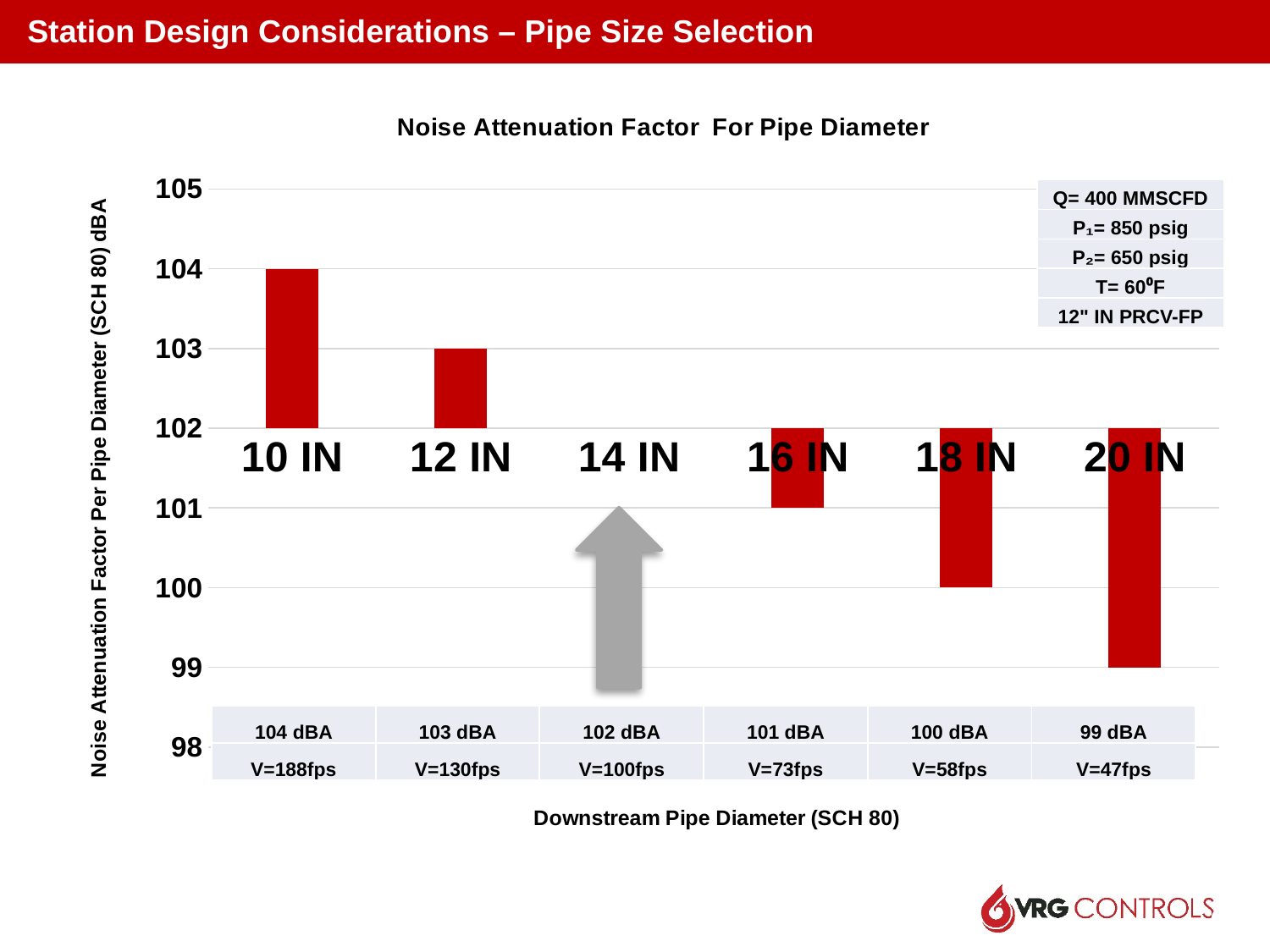
What velocity is listed for the 16 IN pipe diameter? V=73fps Which pipe diameter has the highest noise attenuation factor? 10 IN What is the difference in dBA between the 10 IN and 18 IN pipe diameters? 4 dBA Which pipe diameter has the lowest noise attenuation factor? 20 IN What is the noise attenuation factor for the 20 IN pipe diameter? 99 dBA What is the x-axis label of the chart? Downstream Pipe Diameter (SCH 80) What is the noise attenuation factor for the 10 IN pipe diameter? 104 dBA What kind of chart is shown on the slide? Bar chart Do the noise attenuation values rise or fall as the pipe diameter increases along the x axis? Fall How many pipe diameter categories are shown on the chart? 6 Which has a higher noise attenuation factor, 12 IN or 16 IN? 12 IN What is the title of the chart? Noise Attenuation Factor For Pipe Diameter